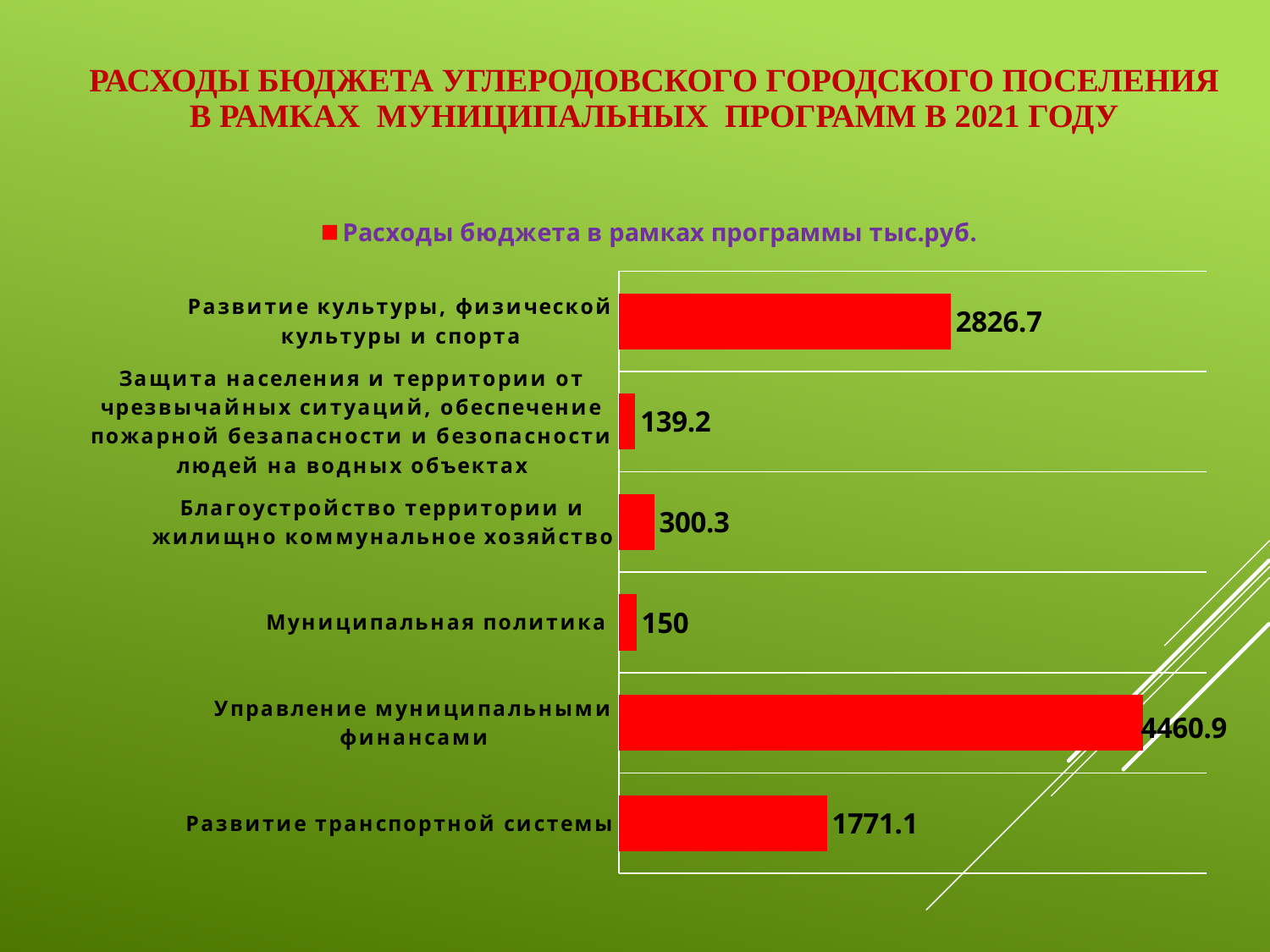
What type of chart is shown on the slide? Bar chart What is the value for «Благоустройство территории и жилищно коммунальное хозяйство»? 300.3 How many programs (categories) are shown in the chart? 6 Which program has the lowest budget expenditure? Защита населения и территории от чрезвычайных ситуаций, обеспечение пожарной безапасности и безопасности людей на водных объектах What is the value for «Развитие культуры, физической культуры и спорта»? 2826.7 What is the difference between the values for «Благоустройство территории и жилищно коммунальное хозяйство» and «Защита населения и территории от чрезвычайных ситуаций...»? 161.1 What is the difference between the values for «Управление муниципальными финансами» and «Развитие культуры, физической культуры и спорта»? 1634.2 What is the value for «Муниципальная политика»? 150 What is the value for «Развитие транспортной системы»? 1771.1 Which is larger: the value for «Развитие транспортной системы» or for «Развитие культуры, физической культуры и спорта»? Развитие культуры, физической культуры и спорта Which program has the highest budget expenditure? Управление муниципальными финансами What is the legend entry of the chart? Расходы бюджета в рамках программы тыс.руб.